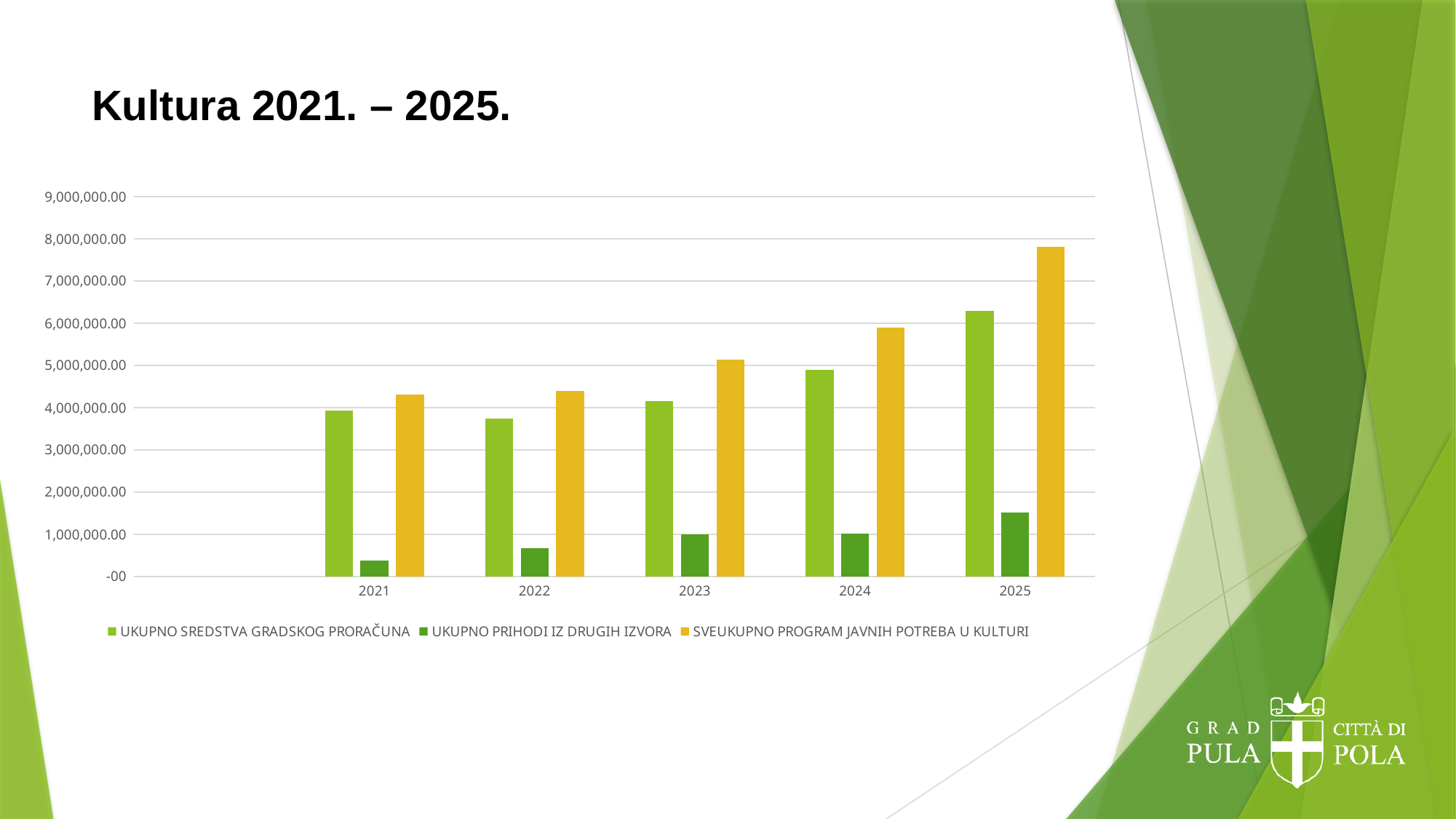
How many years are shown on the x axis? 5 Is the value for UKUPNO PRIHODI IZ DRUGIH IZVORA in 2021 greater or less than 1,000,000.00? less How many series does the legend list? 3 What kind of chart is shown on the slide? bar chart Is the value for UKUPNO SREDSTVA GRADSKOG PRORAČUNA in 2025 greater or less than 6,000,000.00? greater Is the value for SVEUKUPNO PROGRAM JAVNIH POTREBA U KULTURI in 2025 greater or less than 7,000,000.00? greater Which is larger: UKUPNO SREDSTVA GRADSKOG PRORAČUNA in 2021 or in 2022? 2021 In which year is the value for UKUPNO PRIHODI IZ DRUGIH IZVORA lowest? 2021 Do the values for SVEUKUPNO PROGRAM JAVNIH POTREBA U KULTURI rise or fall from 2021 to 2025? rise In which year is the value for UKUPNO SREDSTVA GRADSKOG PRORAČUNA lowest? 2022 What is the title of the slide? Kultura 2021. – 2025. In which year is the value for SVEUKUPNO PROGRAM JAVNIH POTREBA U KULTURI highest? 2025